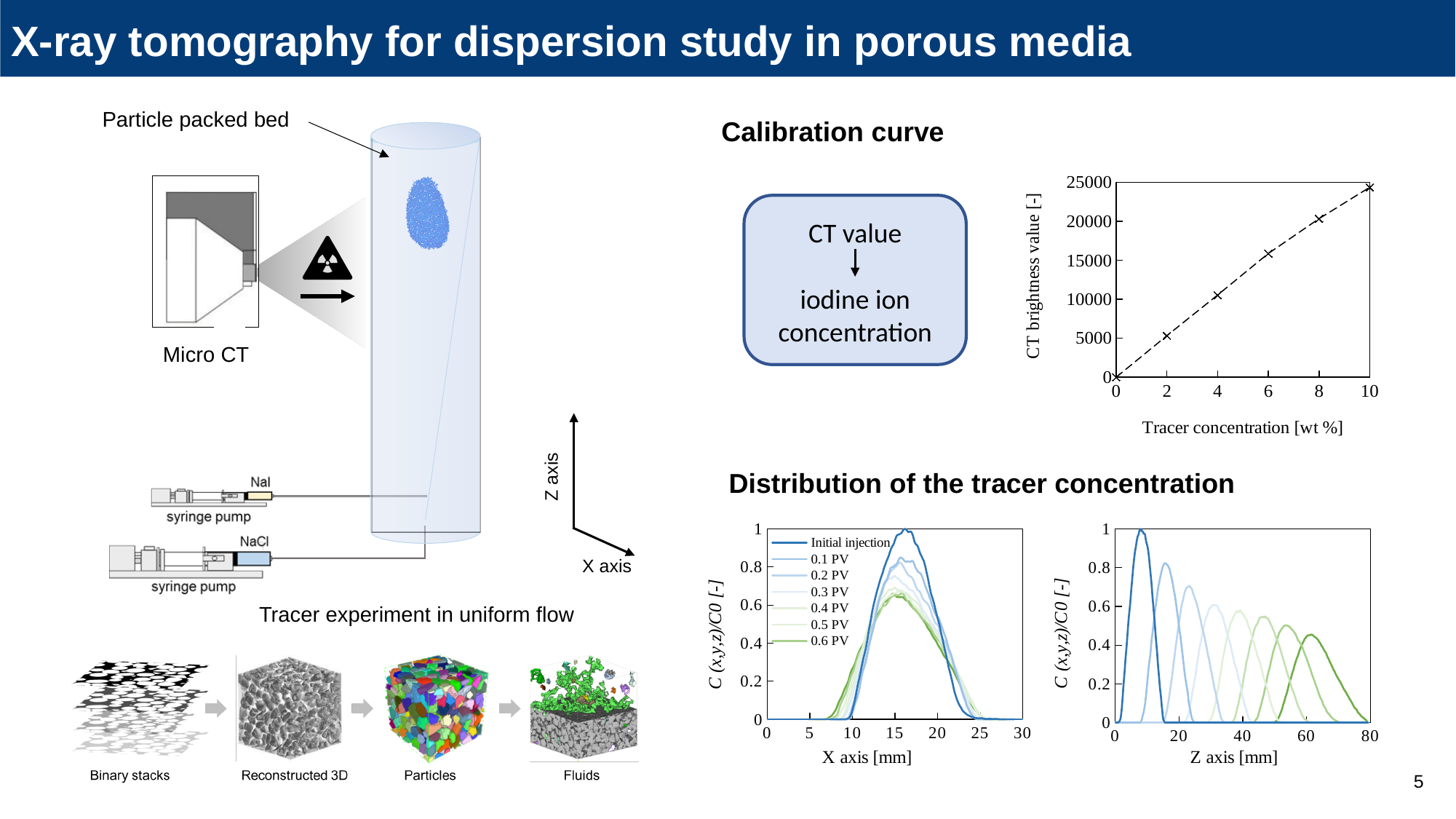
In the left chart under 'Distribution of the tracer concentration' (X axis [mm]), is the peak of the 0.6 PV curve greater or less than 0.8? less In the calibration curve chart, which tracer concentration has the highest CT brightness value? 10 In the calibration curve chart, what is the label of the y axis? CT brightness value [-] In the right chart under 'Distribution of the tracer concentration' (Z axis [mm]), do the peak heights of the curves rise or fall as the Z position increases? fall In the calibration curve chart, how many data points are plotted? 6 In the left chart under 'Distribution of the tracer concentration' (X axis [mm]), which series has the highest peak? Initial injection In the calibration curve chart, what is the label of the x axis? Tracer concentration [wt %] In the calibration curve chart, is the CT brightness value at a tracer concentration of 6 wt % greater or less than 15000? greater In the calibration curve chart, is the CT brightness value at a tracer concentration of 10 wt % greater or less than 20000? greater In the left chart under 'Distribution of the tracer concentration' (X axis [mm]), how many series does the legend list? 7 In the calibration curve chart, does the CT brightness value rise or fall as the tracer concentration increases? rise